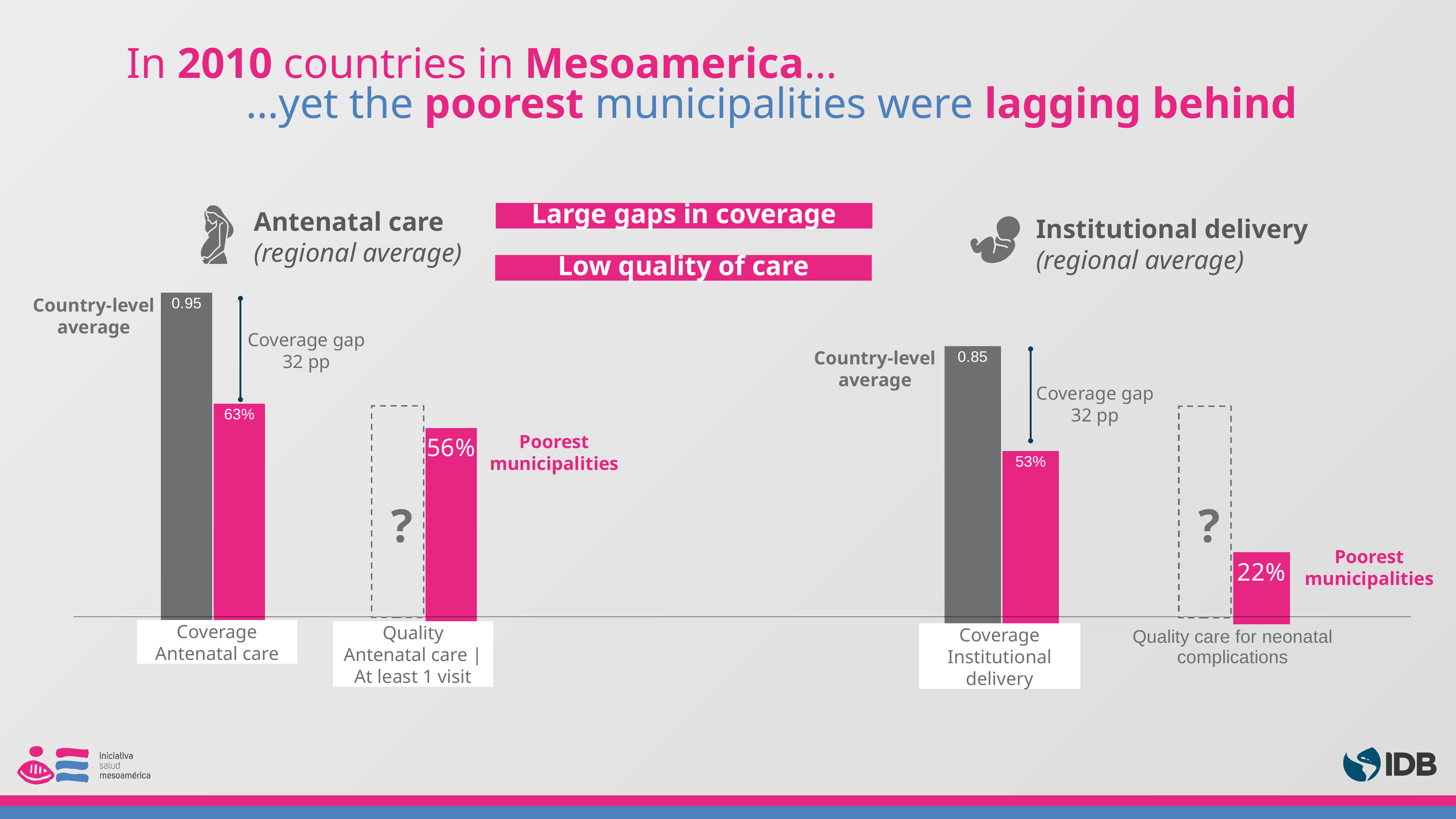
In the Institutional delivery chart, which is lower for the poorest municipalities: Coverage Institutional delivery or Quality care for neonatal complications? Quality care for neonatal complications In the Antenatal care chart, what is the country-level average value for Coverage Antenatal care? 0.95 In the Institutional delivery chart, what is shown in place of a value for the country-level average for Quality care for neonatal complications? ? In the Antenatal care chart, which is larger for the poorest municipalities: Coverage Antenatal care or Quality Antenatal care | At least 1 visit? Coverage Antenatal care In the Antenatal care chart, what coverage gap is labelled between the country-level average and the poorest municipalities? 32 pp In the Institutional delivery chart, what is the value for the poorest municipalities for Coverage Institutional delivery? 53% In the Institutional delivery chart, what coverage gap is labelled between the country-level average and the poorest municipalities? 32 pp What kind of chart is the Antenatal care chart? Bar chart In the Institutional delivery chart, what is the country-level average value for Coverage Institutional delivery? 0.85 In the Antenatal care chart, what is the value for the poorest municipalities for Coverage Antenatal care? 63% In the Antenatal care chart, what is the value for the poorest municipalities for Quality Antenatal care | At least 1 visit? 56% In the Institutional delivery chart, what is the value for the poorest municipalities for Quality care for neonatal complications? 22%